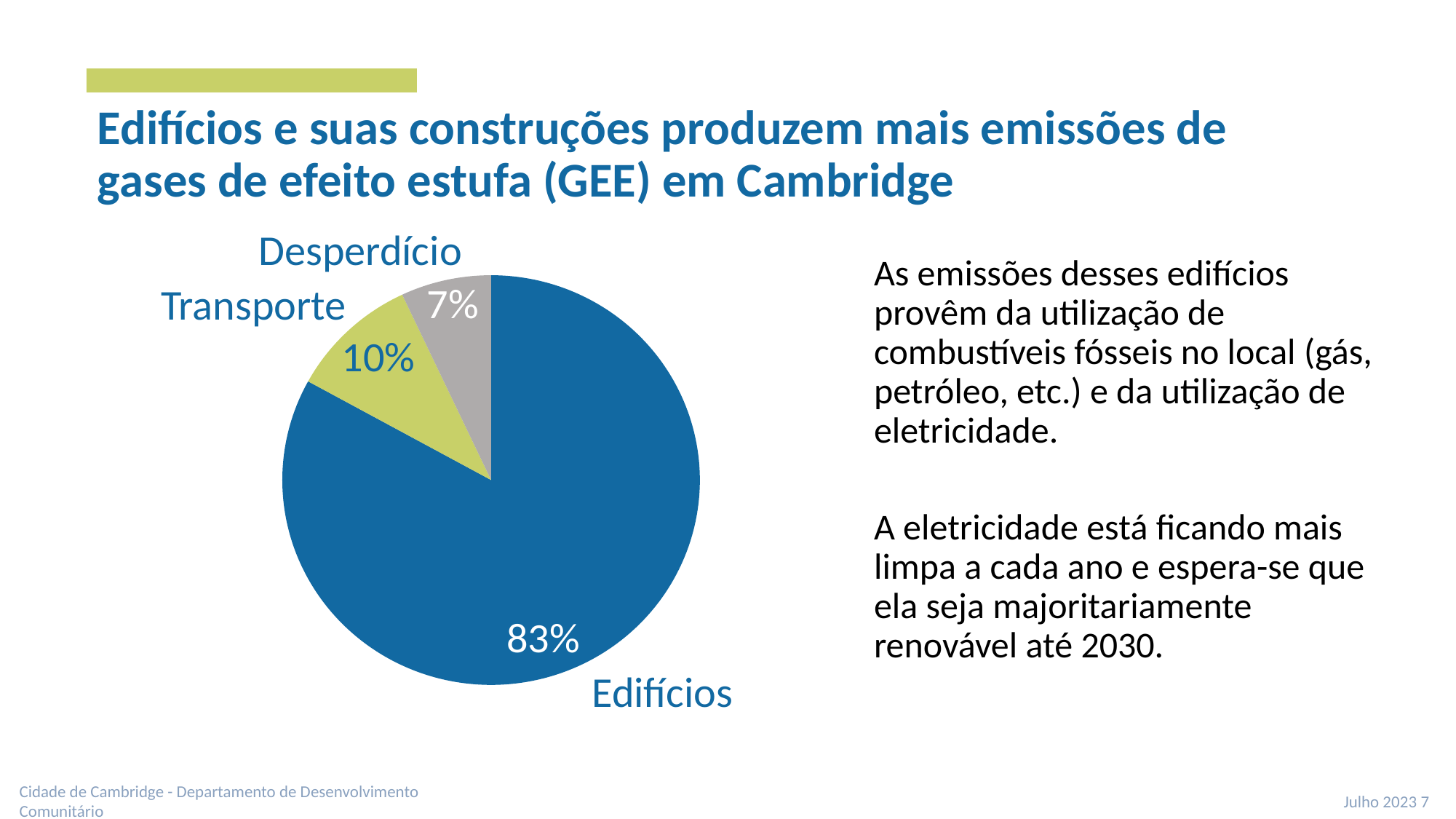
What is the difference in percentage points between Edifícios and Transporte? 73 What is the difference in percentage points between Transporte and Desperdício? 3 Which is larger, the share for Transporte or the share for Desperdício? Transporte What share of the pie does Edifícios account for? 83% How many categories are shown in the pie chart? 3 What share of the pie does Desperdício account for? 7% What colour is the Transporte slice? Green Which category has the smallest slice of the pie? Desperdício What share of the pie does Transporte account for? 10% Which category has the largest slice of the pie? Edifícios What colour is the Desperdício slice? Grey What kind of chart is shown on the slide? Pie chart